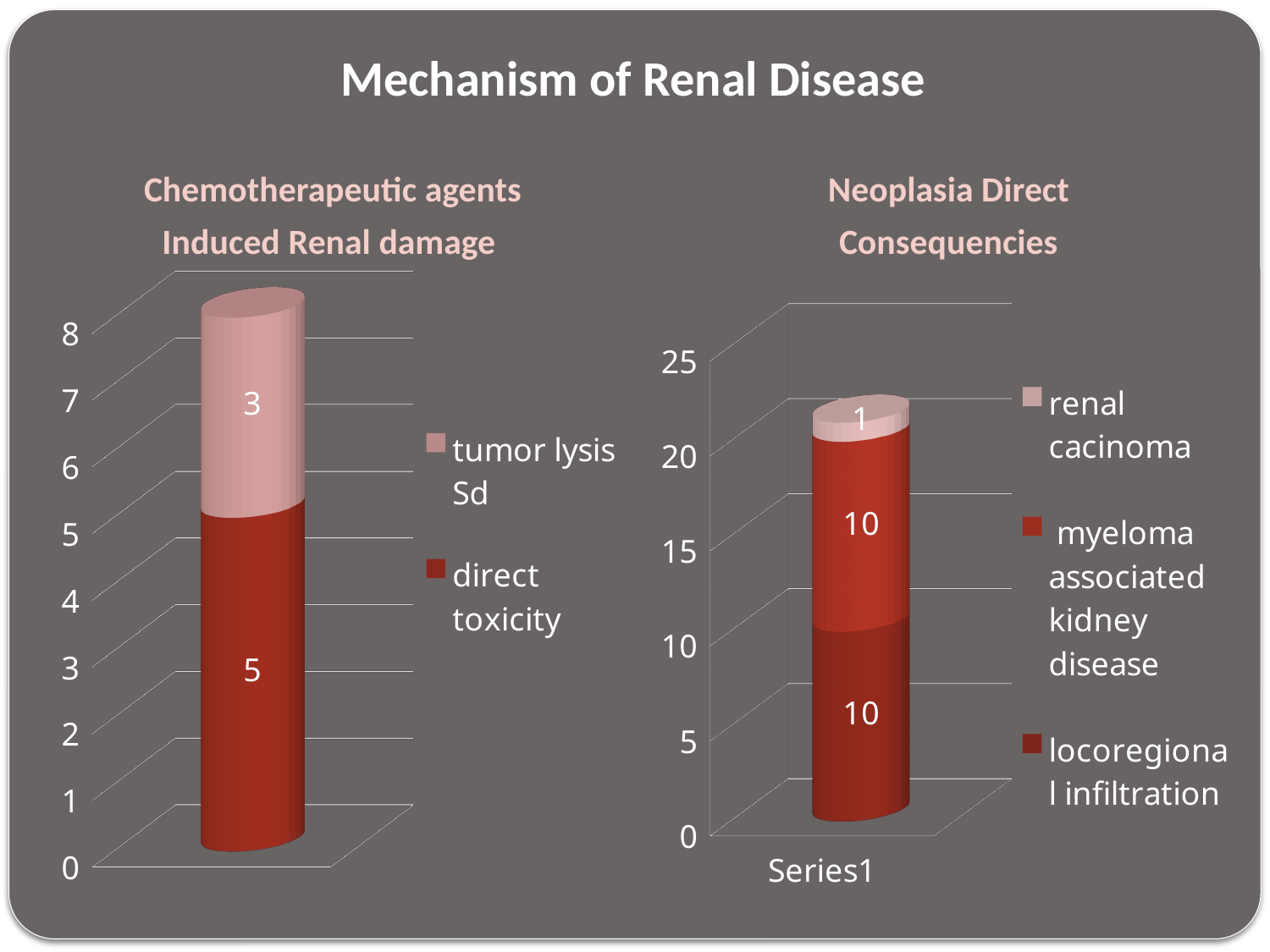
In the 'Neoplasia Direct Consequencies' chart, which segment has the lowest value? renal cacinoma In the 'Chemotherapeutic agents Induced Renal damage' chart, what is the value for tumor lysis Sd? 3 In the 'Neoplasia Direct Consequencies' chart, what is the value for renal cacinoma? 1 In the 'Chemotherapeutic agents Induced Renal damage' chart, how many series does the legend list? 2 In the 'Chemotherapeutic agents Induced Renal damage' chart, what is the value for direct toxicity? 5 In the 'Neoplasia Direct Consequencies' chart, what is the value for myeloma associated kidney disease? 10 What kind of chart is the 'Neoplasia Direct Consequencies' chart? Stacked bar chart In the 'Chemotherapeutic agents Induced Renal damage' chart, what is the total of the stacked bar? 8 In the 'Chemotherapeutic agents Induced Renal damage' chart, what is the difference between direct toxicity and tumor lysis Sd? 2 In the 'Neoplasia Direct Consequencies' chart, what is the total of the stacked bar? 21 In the 'Neoplasia Direct Consequencies' chart, how many series does the legend list? 3 In the 'Chemotherapeutic agents Induced Renal damage' chart, which is larger, direct toxicity or tumor lysis Sd? direct toxicity